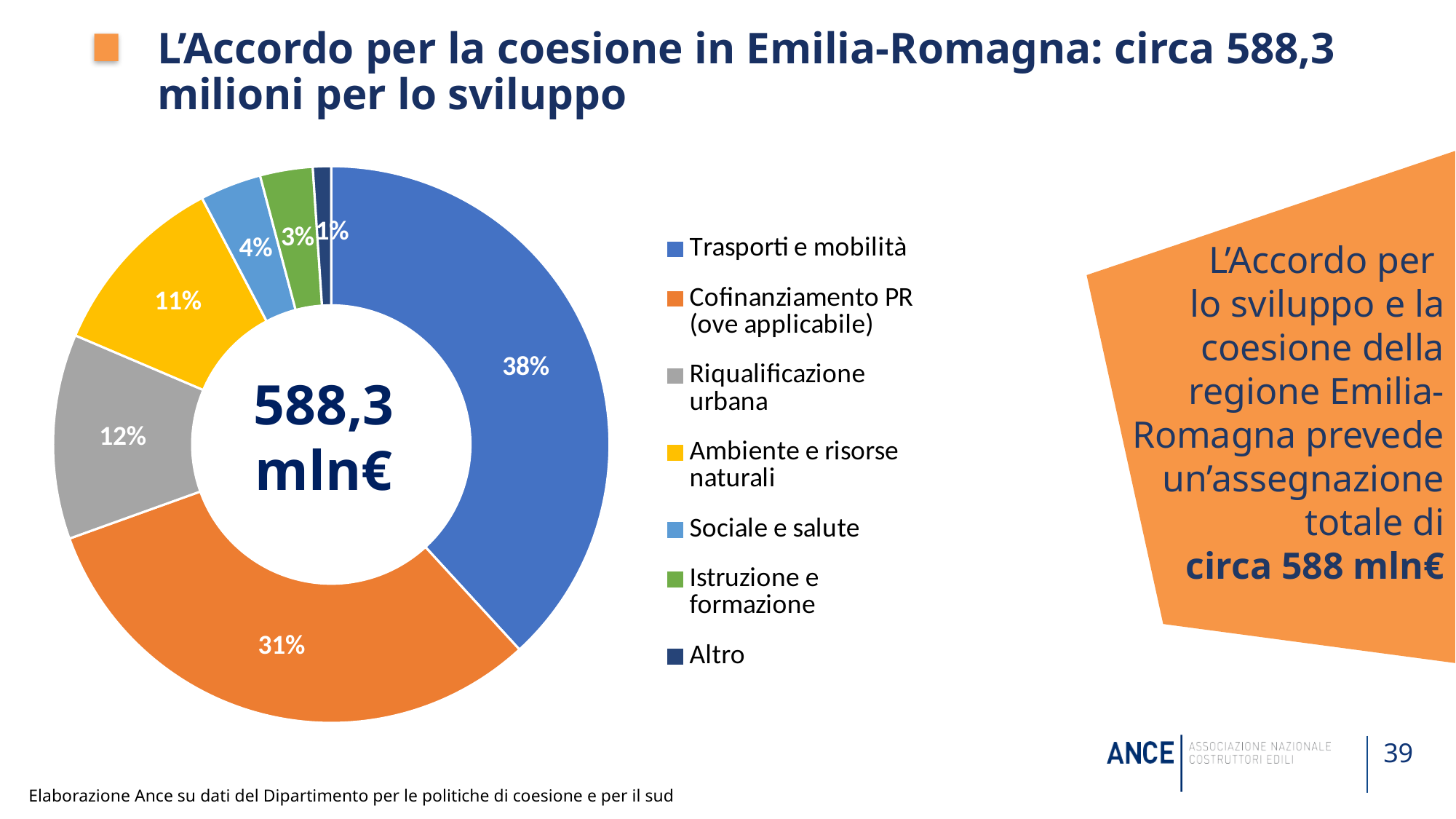
What share of the chart does Istruzione e formazione represent? 3% Which category has the smallest share of the chart? Altro How many categories does the chart show? 7 What kind of chart is shown on the slide? Pie chart (doughnut) What share of the chart does Trasporti e mobilità represent? 38% What share of the chart does Riqualificazione urbana represent? 12% What is the difference in percentage points between Trasporti e mobilità and Cofinanziamento PR (ove applicabile)? 7 percentage points Which is larger: the share for Riqualificazione urbana or the share for Ambiente e risorse naturali? Riqualificazione urbana What share of the chart does Cofinanziamento PR (ove applicabile) represent? 31% What share of the chart does Sociale e salute represent? 4% What share of the chart does Ambiente e risorse naturali represent? 11% Which category has the largest share of the chart? Trasporti e mobilità